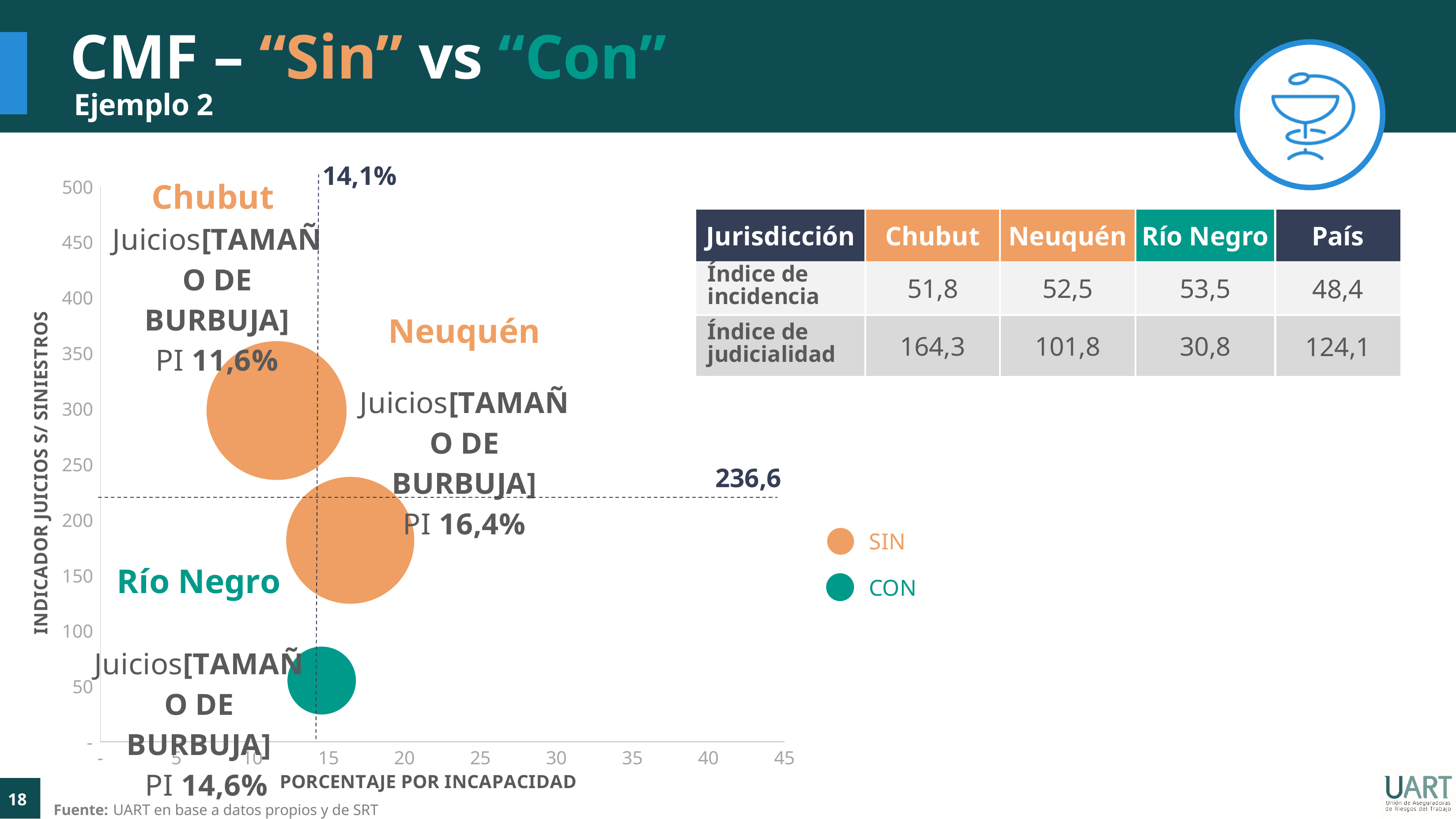
Is the Indicador Juicios s/ Siniestros value for Chubut greater or less than 250? greater How many series does the chart legend list? 2 What kind of chart is shown on the slide? Bubble chart What is the difference between the PI values of Neuquén and Chubut? 4,8 percentage points What value is labelled on the horizontal dashed reference line of the chart? 236,6 What is the PI value labelled for Río Negro? 14,6% What is the PI value labelled for Neuquén? 16,4% Which jurisdiction has the highest labelled PI value? Neuquén Which jurisdiction has the lowest labelled PI value? Chubut How many bubbles (jurisdictions) are plotted on the chart? 3 Is the Indicador Juicios s/ Siniestros value for Río Negro greater or less than 100? less What is the PI (porcentaje por incapacidad) value labelled for Chubut? 11,6%